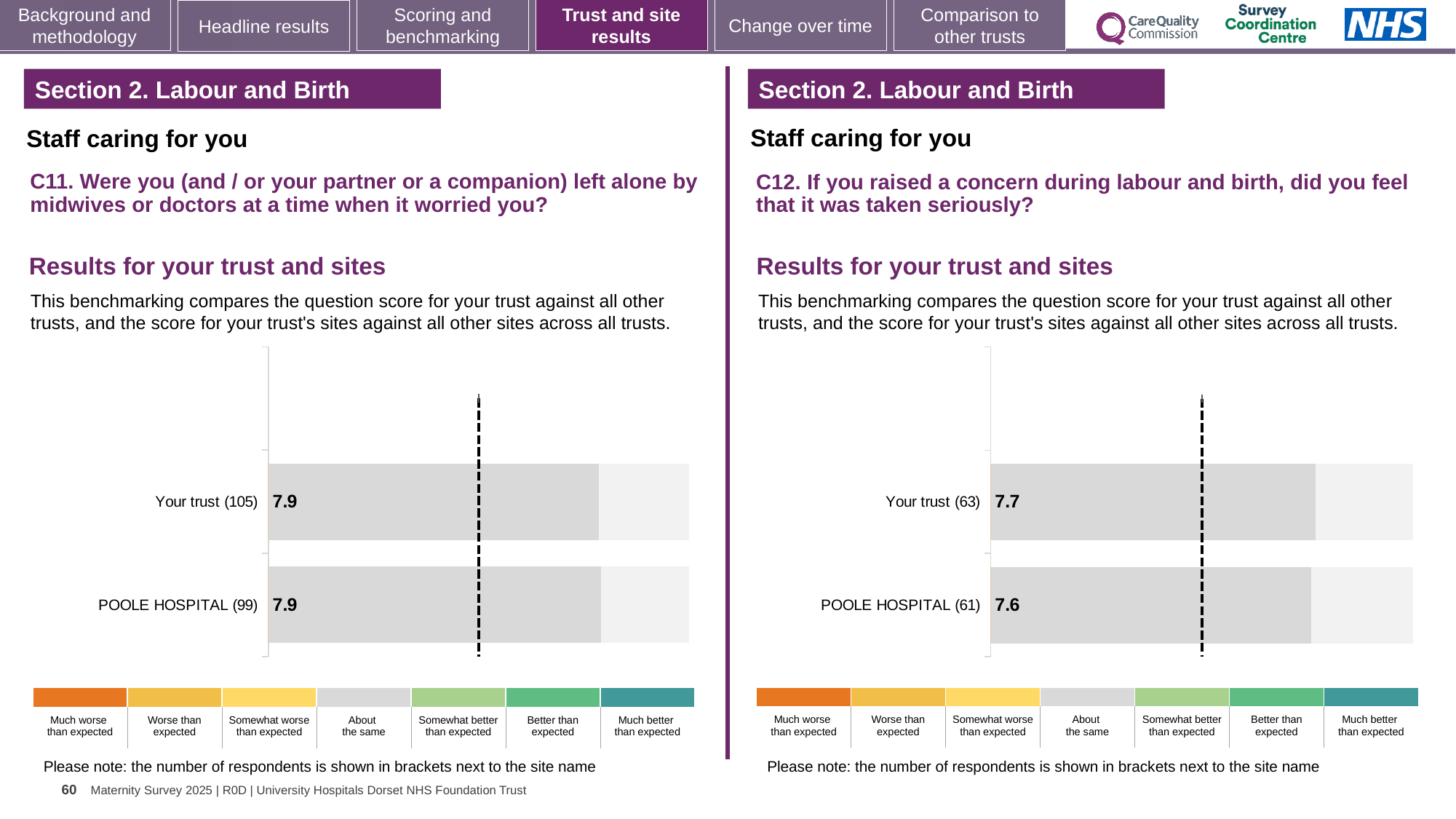
In the C11 chart on the left, are the scores for Your trust and POOLE HOSPITAL the same or different? the same How many respondents are shown in brackets for POOLE HOSPITAL in the C12 chart on the right? 61 In the C11 chart on the left, what is the score for Your trust (105)? 7.9 In the C12 chart on the right, what is the score for POOLE HOSPITAL (61)? 7.6 What type of chart is used for the C12 results on the right? bar chart In the C12 chart on the right, which has the higher score, Your trust or POOLE HOSPITAL? Your trust In the C11 chart on the left, what is the score for POOLE HOSPITAL (99)? 7.9 How many benchmark categories are listed in the colour key below the C11 chart on the left? 7 How many bars are plotted in the C11 chart on the left? 2 In the C12 chart on the right, what is the score for Your trust (63)? 7.7 In the C12 chart on the right, which row has the lowest score? POOLE HOSPITAL (61) In the C12 chart on the right, what is the difference between the score for Your trust and the score for POOLE HOSPITAL? 0.1